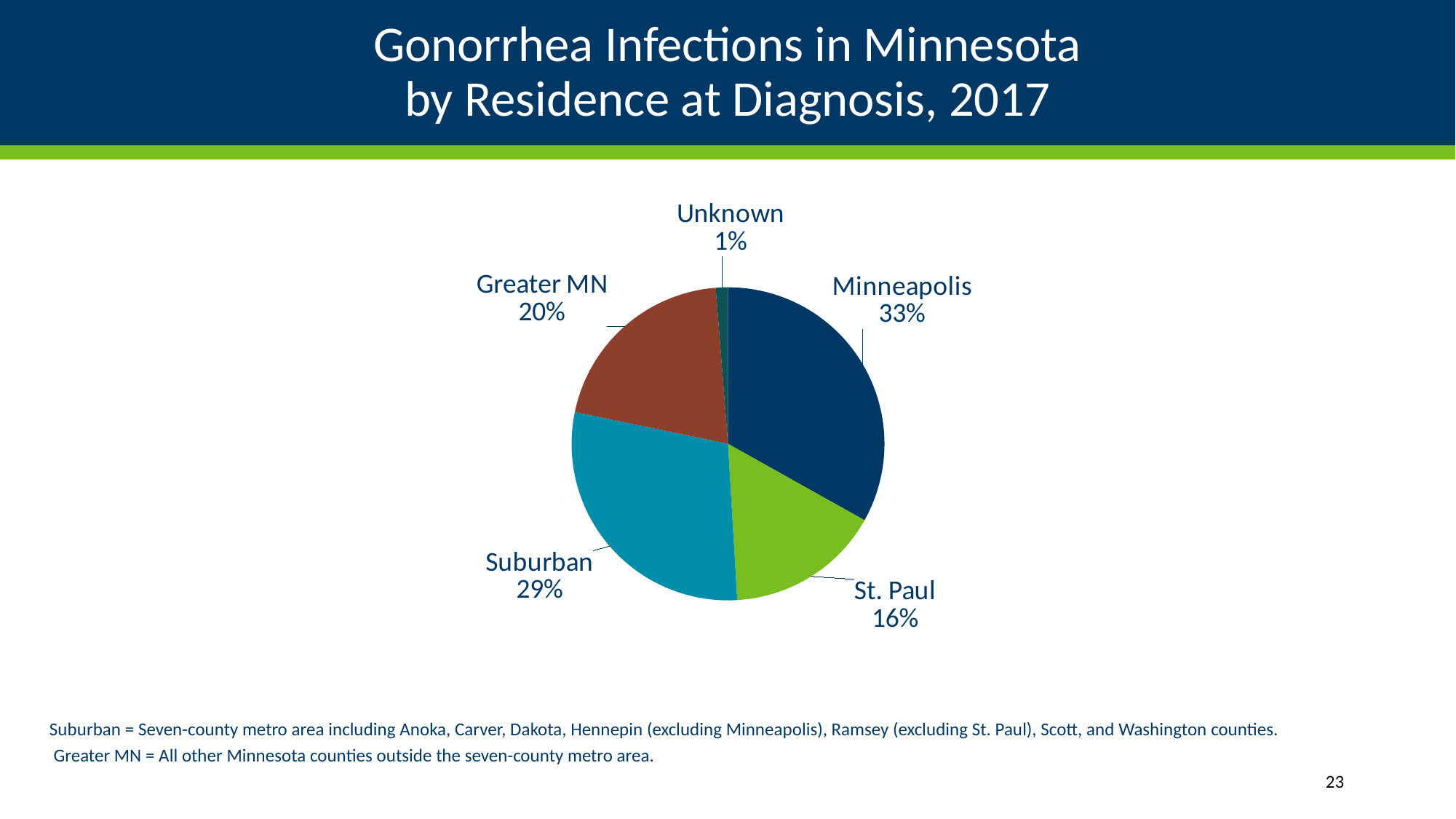
Which residence category has the smallest share of infections? Unknown What share of gonorrhea infections were among Minneapolis residents? 33% What share of infections is shown for Greater MN? 20% Which residence category has the largest share of infections? Minneapolis Which has a larger share of infections, Suburban or Greater MN? Suburban What percentage of infections is attributed to Suburban residents? 29% What percentage of infections is shown for St. Paul? 16% How many percentage points larger is the Minneapolis share than the St. Paul share? 17 What share of infections has an Unknown residence? 1% What is the combined share of infections for Minneapolis and St. Paul? 49% What type of chart is used on this slide? Pie chart How many residence categories are shown in the pie chart? 5